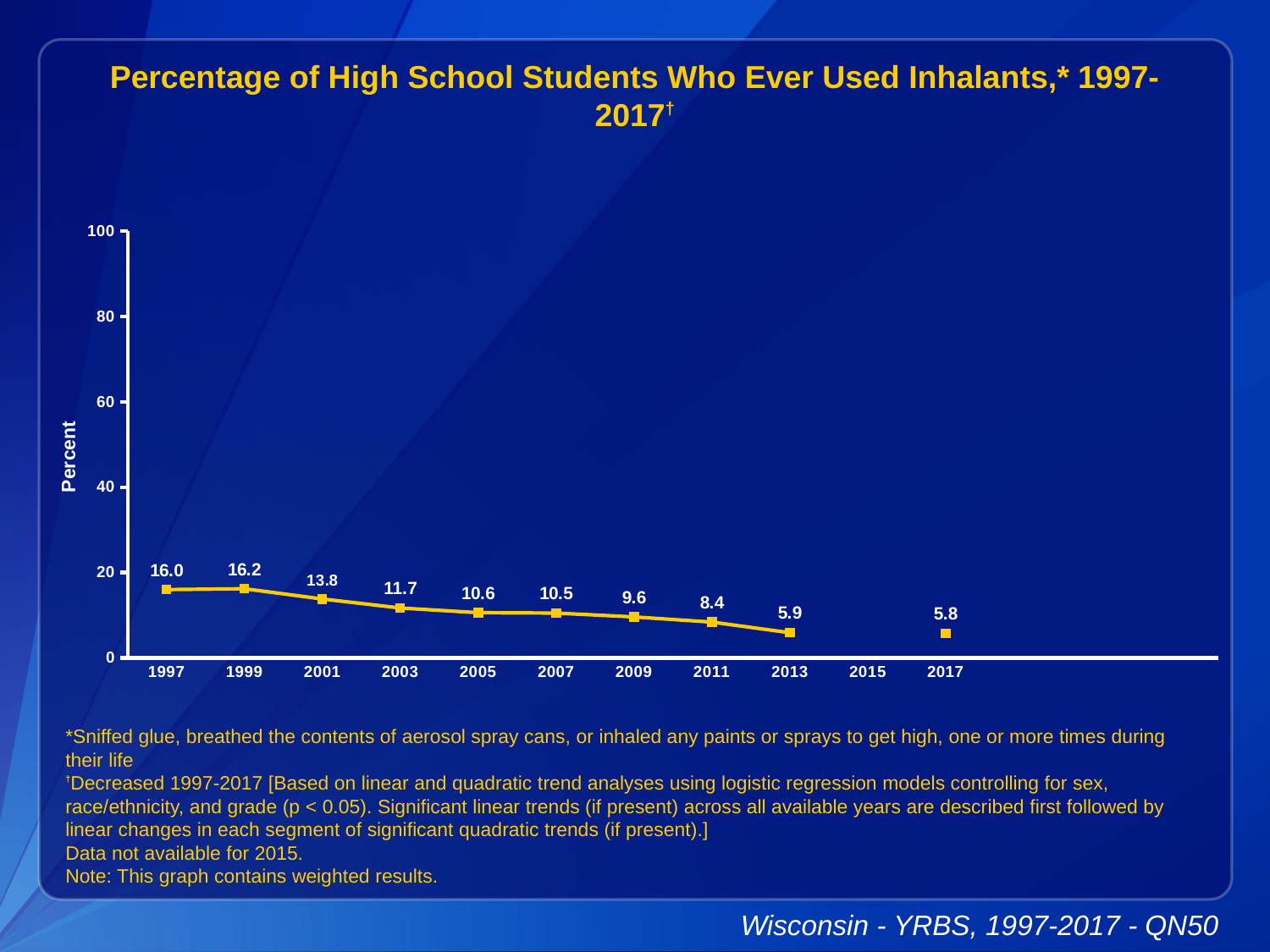
Which year has the highest value? 1999 What is the label on the y axis? Percent How many years have a plotted data point? 10 What kind of chart is this? line chart What is the value for 2011? 8.4 Which year has the lowest value? 2017 What is the value for 1997? 16.0 Is the value for 2001 greater or less than 20? less Which is larger, the value for 2003 or the value for 2009? 2003 Do the values generally rise or fall from 1997 to 2017? fall What is the difference between the values for 1997 and 2013? 10.1 What is the value for 2017? 5.8